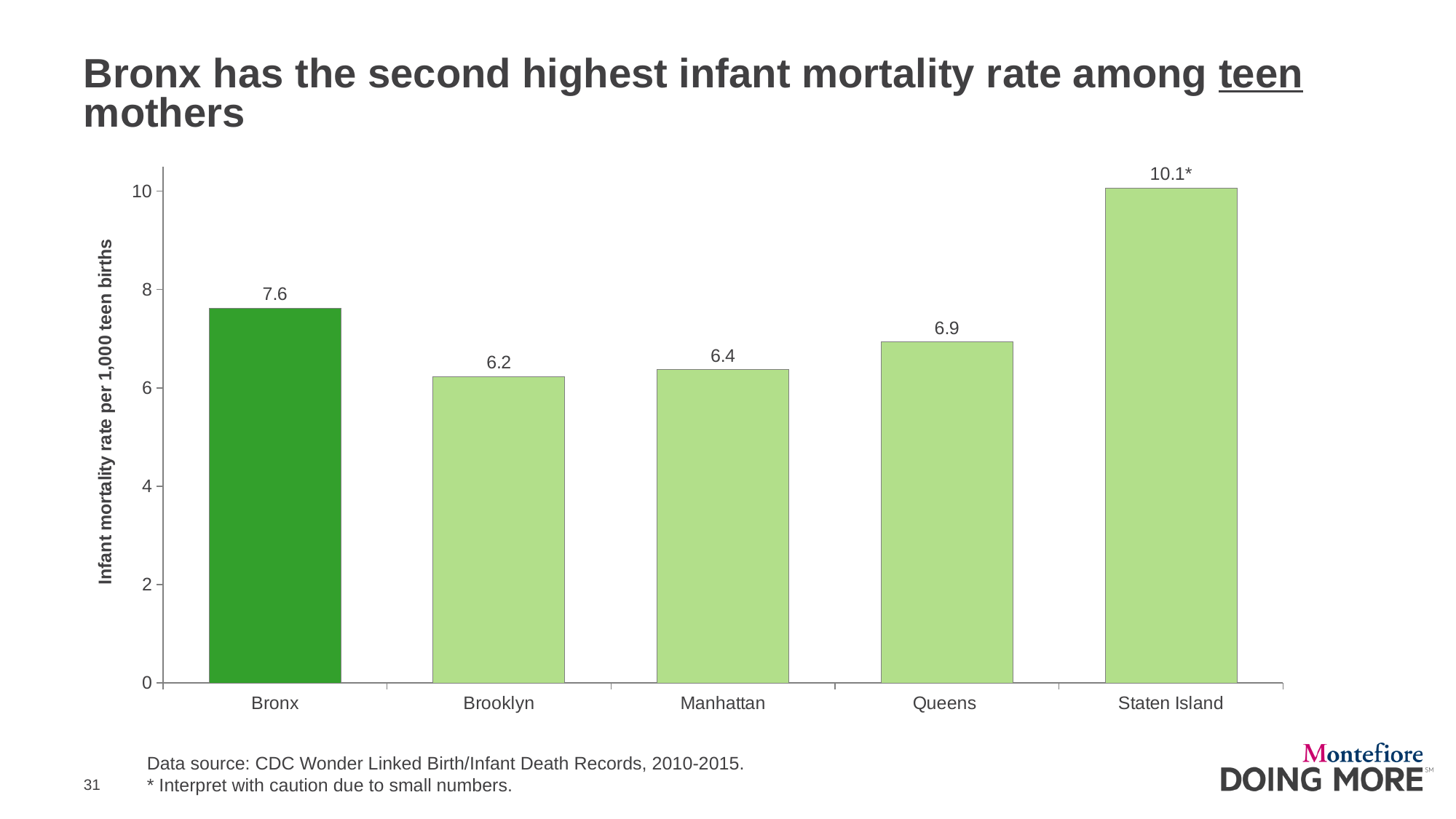
Which borough has the lowest infant mortality rate among teen mothers? Brooklyn What is the infant mortality rate per 1,000 teen births for Queens? 6.9 What is the infant mortality rate per 1,000 teen births for Brooklyn? 6.2 What is the difference between the infant mortality rates for the Bronx and Brooklyn? 1.4 What is the infant mortality rate per 1,000 teen births for the Bronx? 7.6 Which has a higher infant mortality rate among teen mothers, Manhattan or Queens? Queens How many boroughs are shown on the chart? 5 What is the difference between the infant mortality rates for Staten Island and the Bronx? 2.5 Which bar is shaded a darker green than the others? Bronx Which borough has the highest infant mortality rate among teen mothers? Staten Island What kind of chart is shown on the slide? Bar chart Is the value for Staten Island greater or less than 10? greater